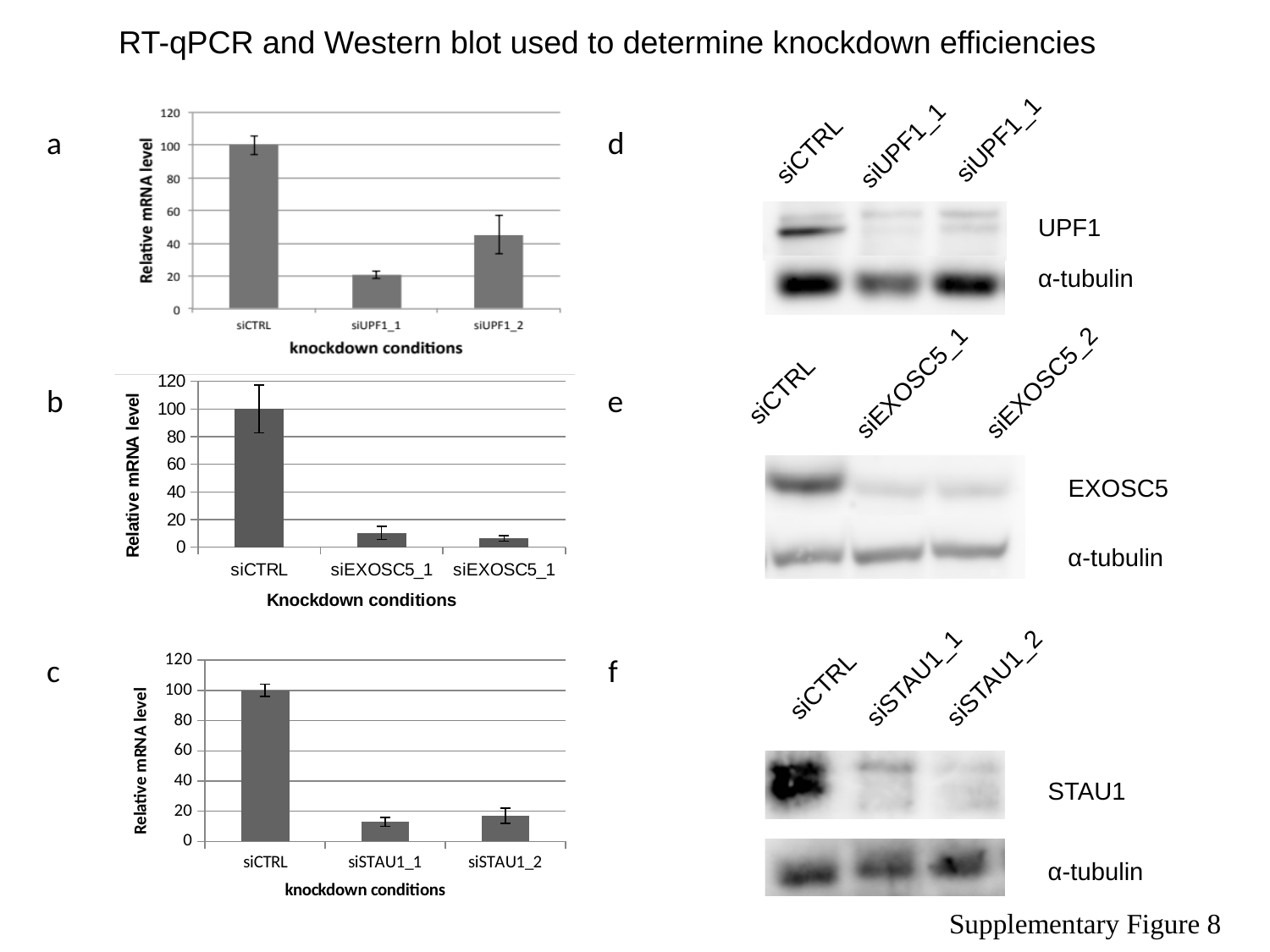
In chart a (top left), which knockdown condition has the highest relative mRNA level? siCTRL In chart b (middle left), which knockdown condition has the highest relative mRNA level? siCTRL In chart a (top left), which has a higher relative mRNA level, siUPF1_1 or siUPF1_2? siUPF1_2 In chart c (bottom left), is the relative mRNA level for siSTAU1_1 greater or less than 40? less In chart b (middle left), what is the relative mRNA level for siCTRL? 100 In chart a (top left), is the relative mRNA level for siUPF1_2 greater or less than 20? greater In chart a (top left), which knockdown condition has the lowest relative mRNA level? siUPF1_1 What kind of chart is chart a (top left)? bar chart In chart c (bottom left), which knockdown condition has the highest relative mRNA level? siCTRL In chart a (top left), how many knockdown conditions are shown on the x axis? 3 What is the y-axis title of chart c (bottom left)? Relative mRNA level In chart c (bottom left), how many bars are plotted? 3